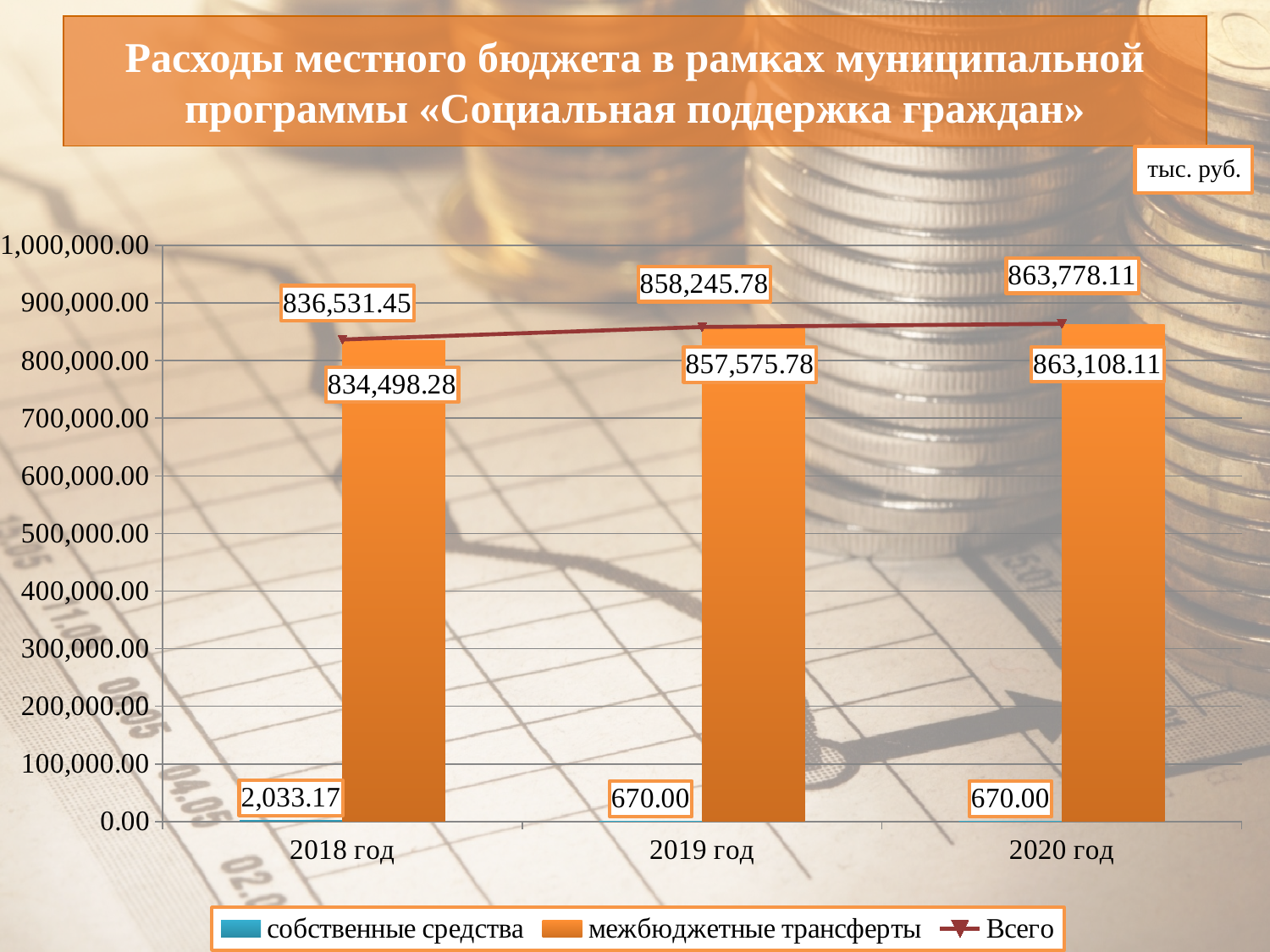
Is the value of межбюджетные трансферты for 2018 год greater or less than 800,000.00? greater What is the difference between межбюджетные трансферты in 2020 год and 2019 год? 5,532.33 What is the value of собственные средства for 2018 год? 2,033.17 Does the Всего line rise or fall from 2018 год to 2020 год? rise How many series does the legend list? 3 What is the value of межбюджетные трансферты for 2019 год? 857,575.78 Which is larger: Всего for 2018 год or Всего for 2019 год? 2019 год In which year is the value of межбюджетные трансферты lowest? 2018 год By how much does собственные средства in 2018 год exceed собственные средства in 2019 год? 1,363.17 What is the Всего value for 2020 год? 863,778.11 How many years are shown on the x axis? 3 In which year is the Всего value highest? 2020 год